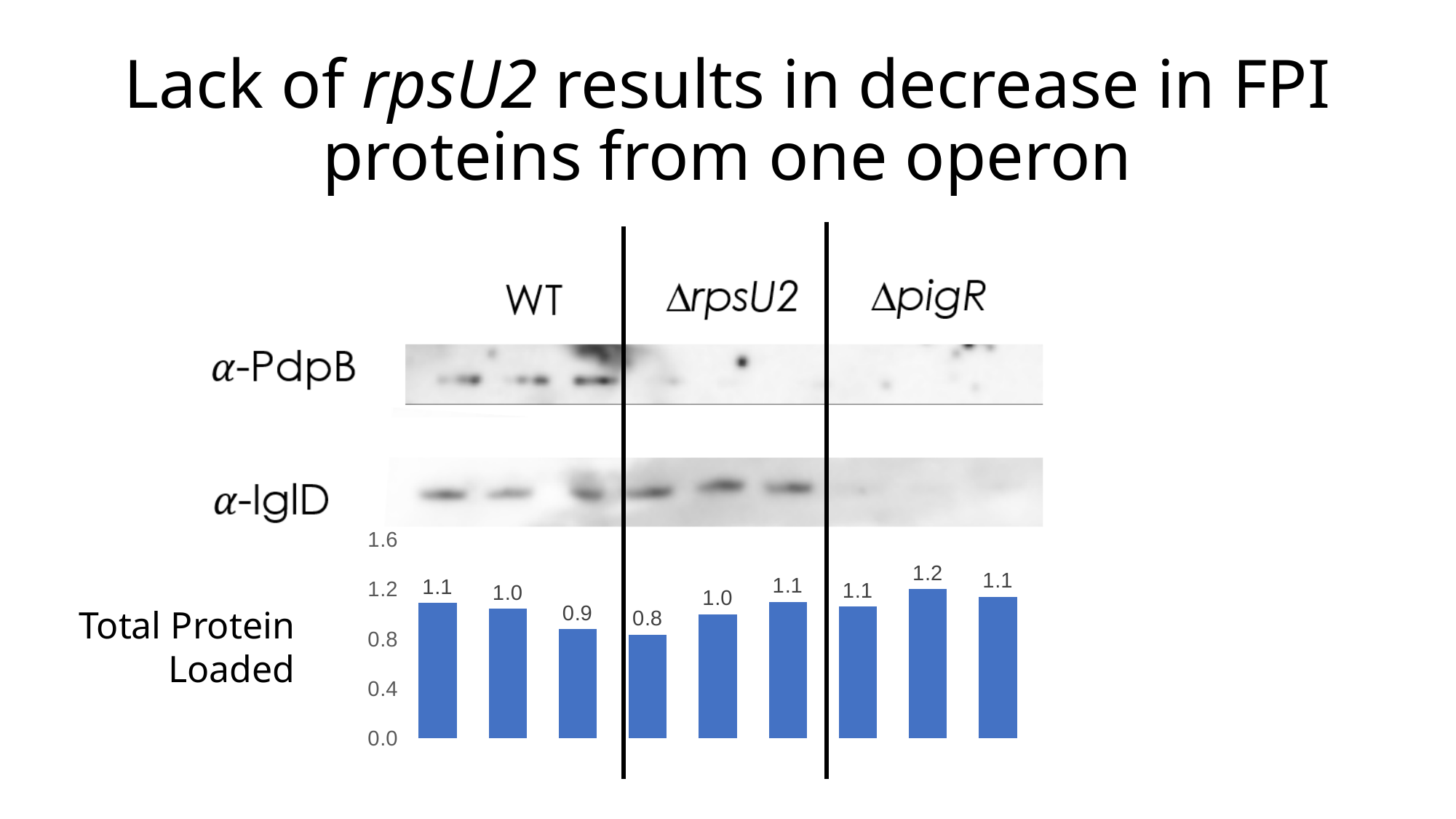
In the Total Protein Loaded chart, is the value of the first bar in the ΔrpsU2 group greater or less than 1.2? less How many bars are plotted in the Total Protein Loaded chart? 9 In the Total Protein Loaded chart, what is the value of the second bar in the ΔpigR group? 1.2 In the Total Protein Loaded chart, what is the value of the first bar in the ΔrpsU2 group? 0.8 In the Total Protein Loaded chart, what is the difference between the highest bar (1.2) and the lowest bar (0.8)? 0.4 In the Total Protein Loaded chart, do the bar values rise or fall from left to right within the ΔrpsU2 group? rise In the Total Protein Loaded chart, what is the lowest value shown on any bar? 0.8 In the Total Protein Loaded chart, which is larger: the third bar in the WT group or the first bar in the ΔrpsU2 group? the third bar in the WT group In the Total Protein Loaded chart, what is the value of the third bar in the WT group? 0.9 In the Total Protein Loaded chart, what is the highest value shown on any bar? 1.2 What kind of chart is the Total Protein Loaded chart? bar chart In the Total Protein Loaded chart, what is the value of the first bar in the WT group? 1.1